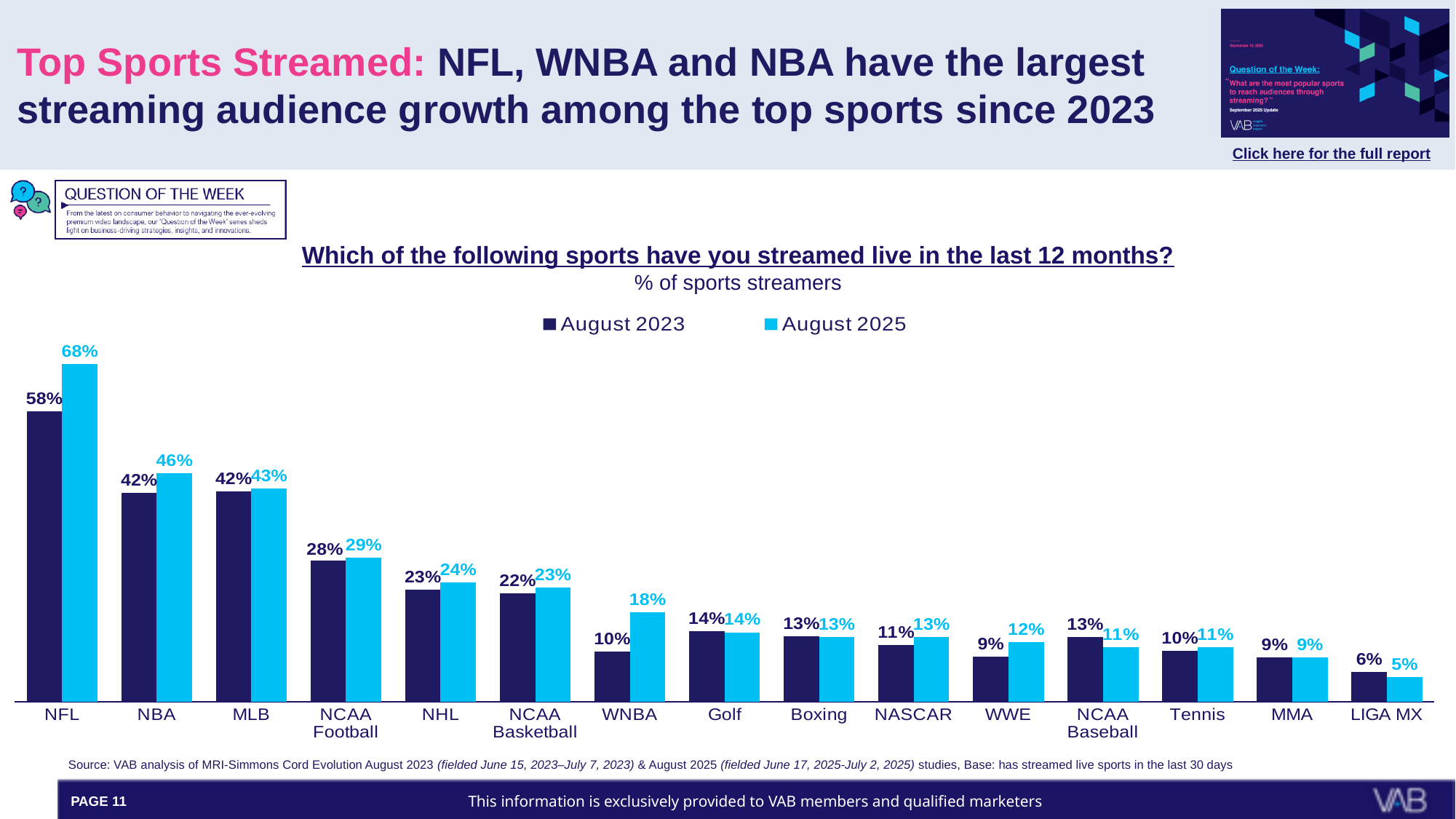
How many series does the legend list? 2 What was the August 2023 value for the WNBA? 10% What is the difference between the NFL's August 2025 and August 2023 values? 10 How many sports are shown on the x axis of the chart? 15 Which is larger for NCAA Baseball: the August 2023 value or the August 2025 value? August 2023 What percentage of sports streamers streamed the NFL live in August 2025? 68% Which sport has the highest August 2025 value? NFL By how many percentage points did the WNBA value increase from August 2023 to August 2025? 8 What was the August 2025 value for NCAA Baseball? 11% Which sport has the lowest August 2025 value? LIGA MX Which colour represents August 2025 in the chart? Light blue What type of chart is shown on the slide? Bar chart